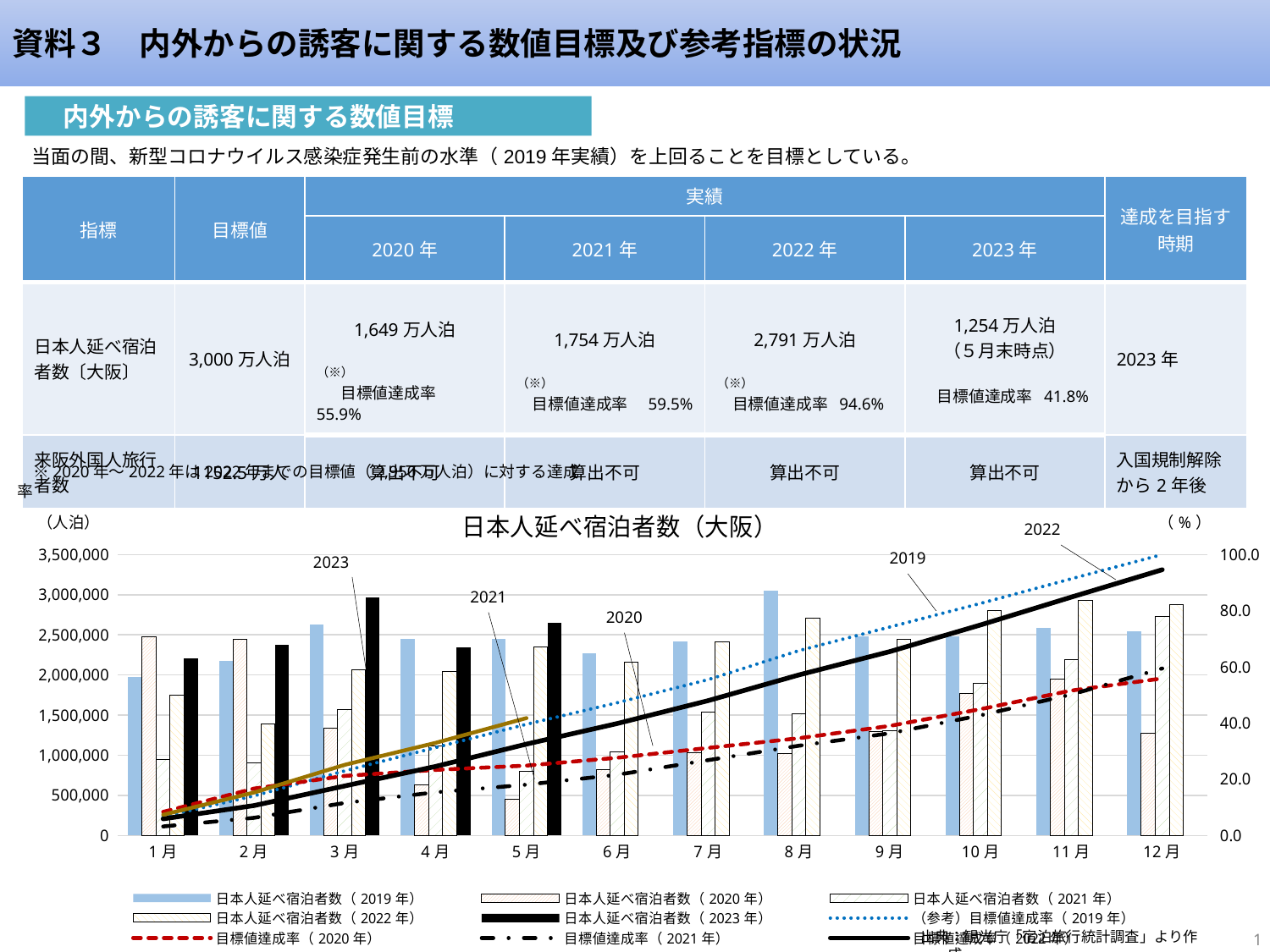
How many months (categories) are shown on the x axis of the chart? 12 Is the 日本人延べ宿泊者数（2023年） value for 3月 greater or less than 2,500,000? greater Which is larger: the 日本人延べ宿泊者数（2023年） bar for 1月 or for 3月? 3月 In which month is the 日本人延べ宿泊者数（2019年） bar the highest? 8月 Do the 目標値達成率 lines rise or fall from 1月 to 12月? rise Is the 日本人延べ宿泊者数（2020年） value for 5月 greater or less than 500,000? less What kind of chart is shown on the slide? A combined bar and line chart What is the title of the chart on the slide? 日本人延べ宿泊者数（大阪） How many series does the chart legend list? 9 Is the 日本人延べ宿泊者数（2022年） value for 12月 greater or less than 2,500,000? greater In which month is the 日本人延べ宿泊者数（2019年） bar the lowest? 1月 In which month is the 日本人延べ宿泊者数（2023年） bar the highest? 3月